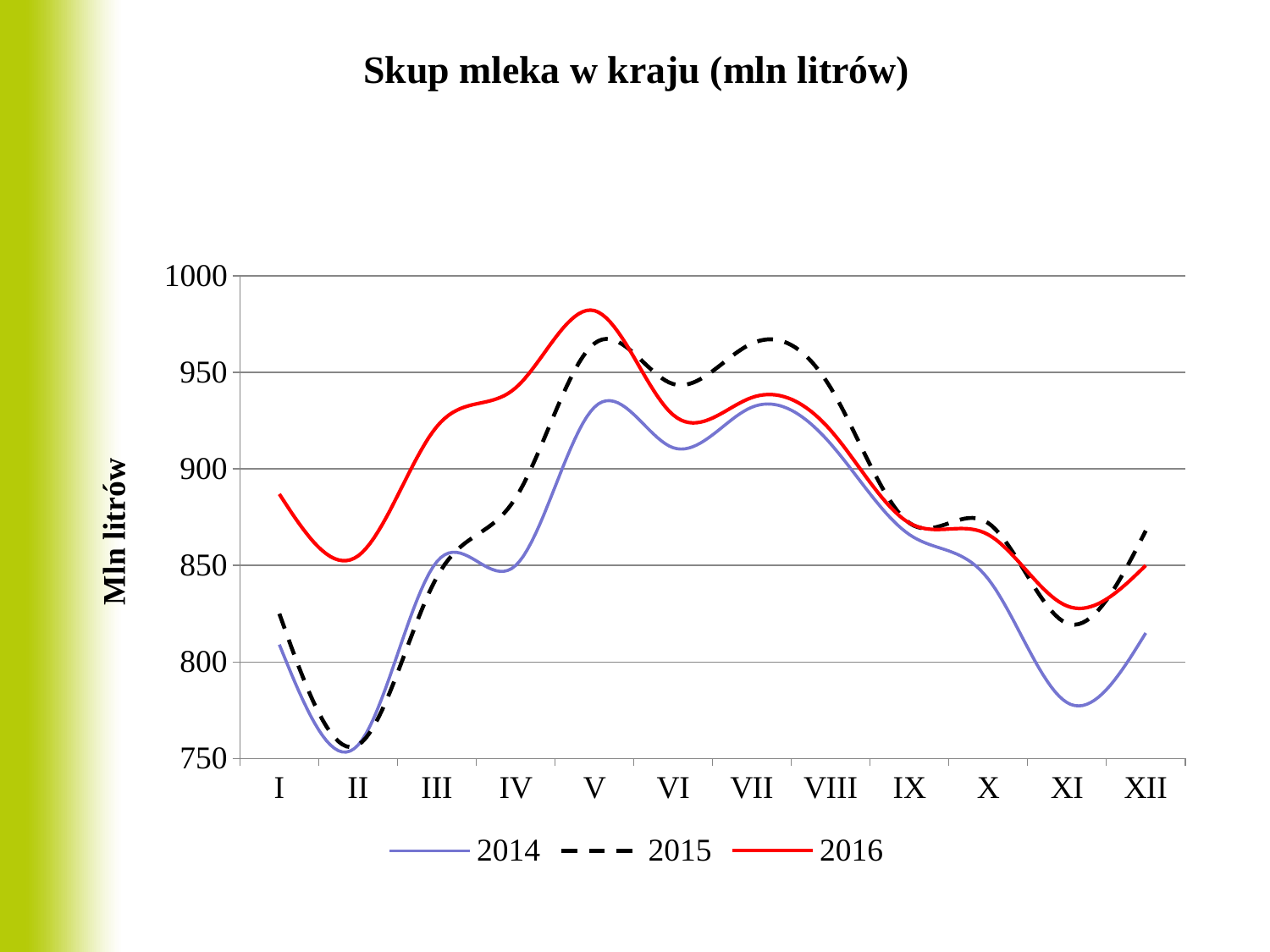
In which month does the 2016 series reach its highest value? V Is the value for 2014 in month XI greater or less than 800? less In which month does the 2014 series reach its lowest value? II In month III, which series has the higher value, 2014 or 2016? 2016 In which month does the 2016 series reach its lowest value? XI In month VII, which series has the higher value, 2015 or 2016? 2015 Is the value for 2016 in month V greater or less than 950? greater Is the value for 2016 in month I greater or less than 850? greater How many series does the legend list? 3 What kind of chart is shown on the slide? line chart What is the title of the chart? Skup mleka w kraju (mln litrów) How many months are plotted along the x axis? 12